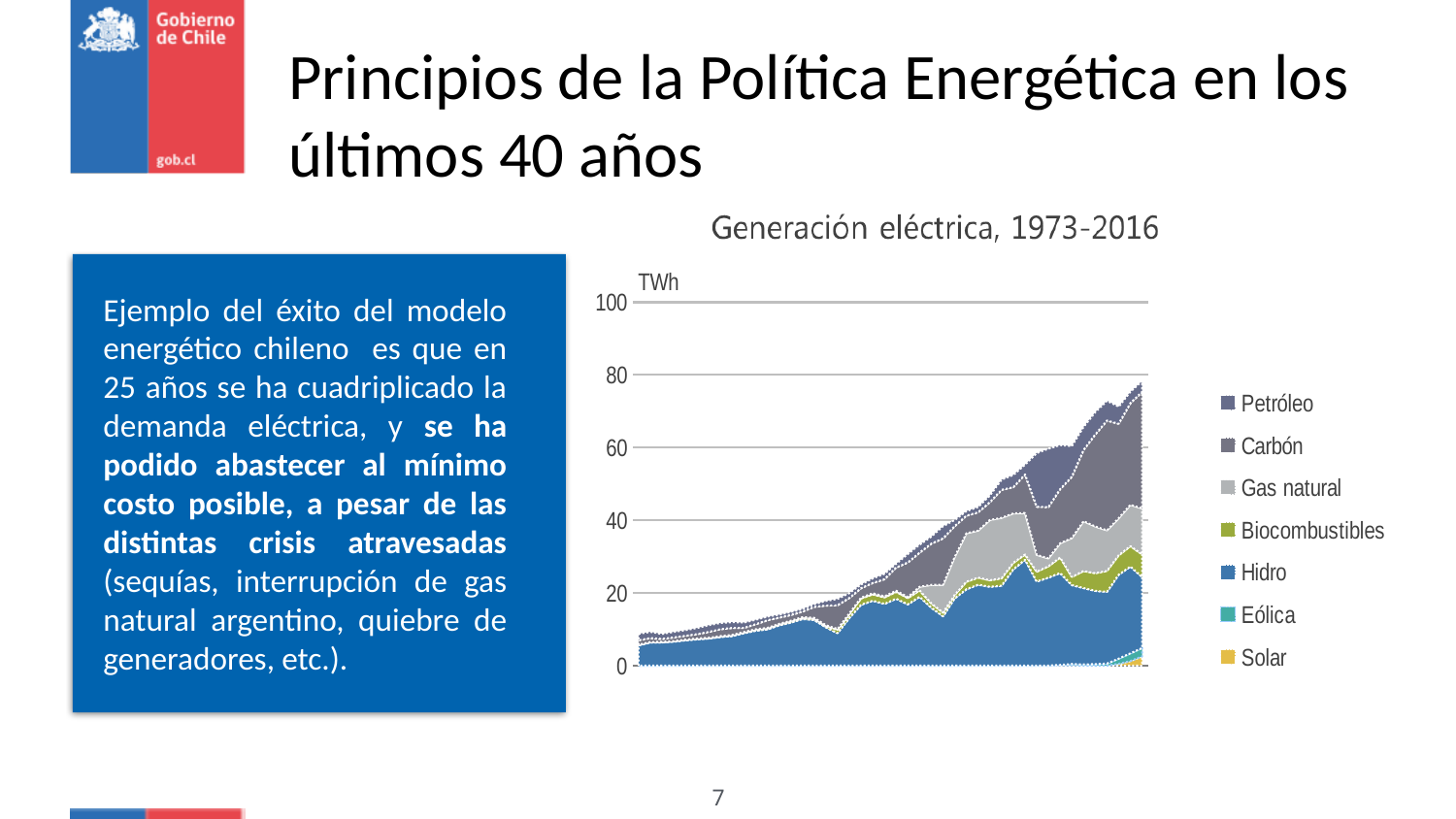
What type of chart is shown on the slide? Stacked area chart Is the total electricity generation at the left end of the chart (1973) greater or less than 20 TWh? less What is the highest value shown on the vertical axis of the chart? 100 Which energy source contributes the largest share of electricity generation across the chart? Hidro Does total electricity generation rise or fall over the period shown in the chart? Rise At the right end of the chart, which contributes more to generation: Hidro or Solar? Hidro What is the title of the chart on the slide? Generación eléctrica, 1973-2016 Is the total electricity generation at the right end of the chart (2016) greater or less than 60 TWh? greater How many series does the chart's legend list? 7 What unit is shown on the vertical axis of the chart? TWh